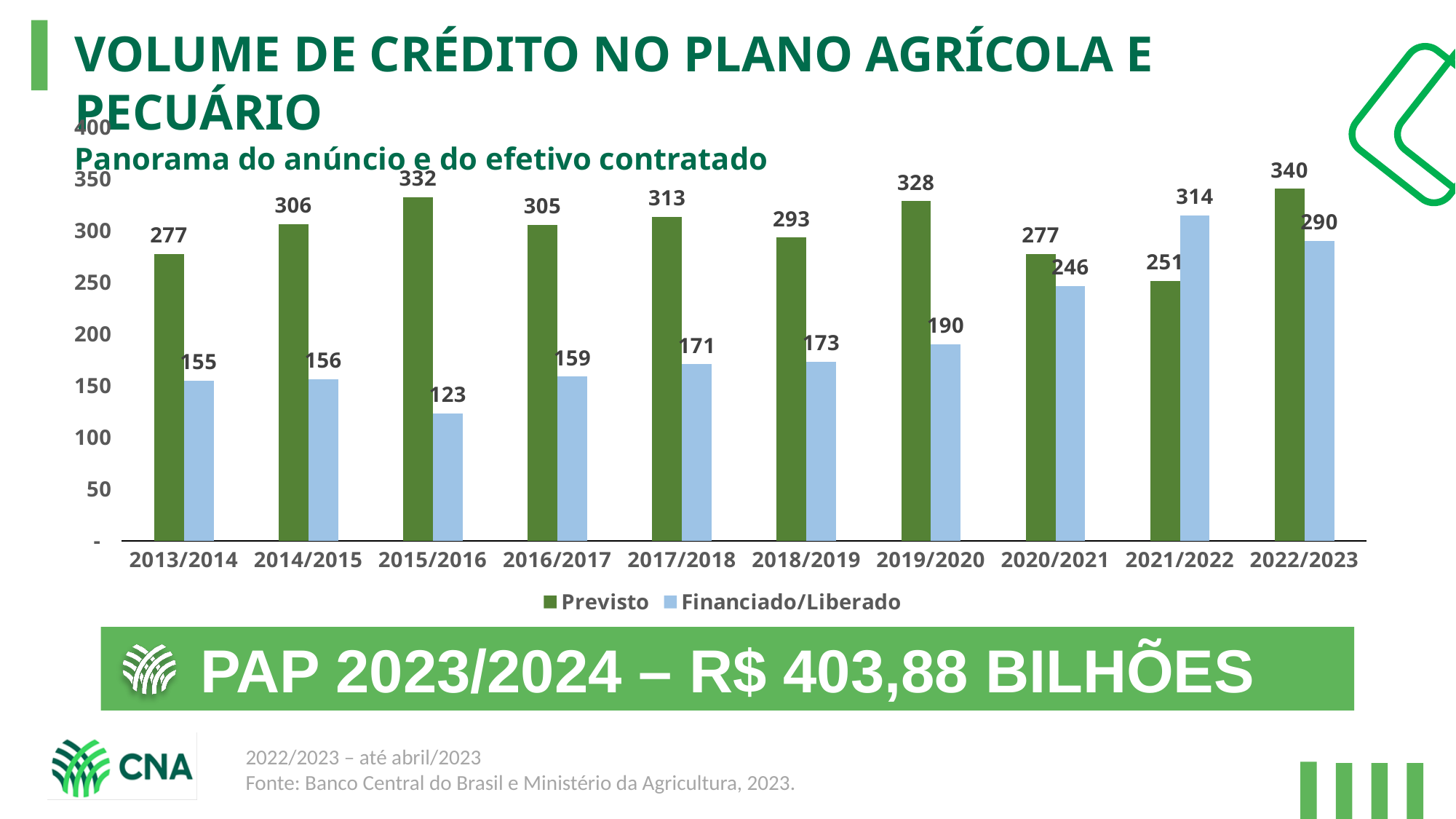
How many series does the legend list? 2 How many years (categories) are shown on the x axis? 10 Which year has the highest Previsto value? 2022/2023 What is the Financiado/Liberado value for 2021/2022? 314 In 2021/2022, which is larger: Previsto or Financiado/Liberado? Financiado/Liberado What is the Previsto value for 2015/2016? 332 Which year has the lowest Previsto value? 2021/2022 What kind of chart is shown on the slide? Bar chart Which year has the lowest Financiado/Liberado value? 2015/2016 What is the difference between Previsto and Financiado/Liberado in 2022/2023? 50 What is the Financiado/Liberado value for 2013/2014? 155 Which series is shown in light blue in the legend? Financiado/Liberado